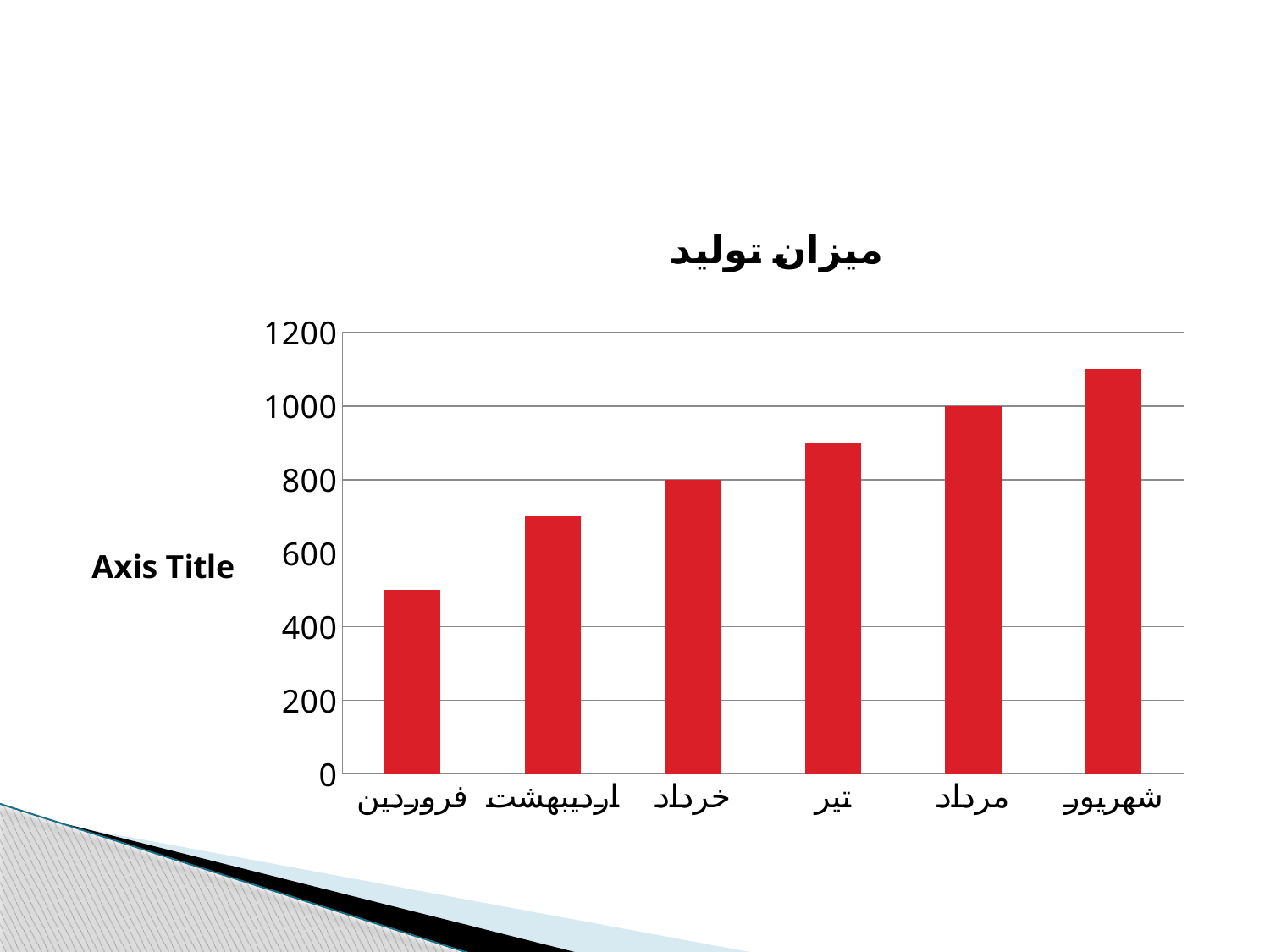
Which category has the lowest value? فروردین What is the value for مرداد? 1000 What is the title of the chart? میزان تولید How many categories are shown on the x axis of the chart? 6 Do the values rise or fall from فروردین to شهریور along the x axis? rise Is the value for فروردین greater or less than 600? less Is the value for شهریور greater or less than 1000? greater Which is larger, the value for تیر or the value for اردیبهشت? تیر What type of chart is shown on the slide? bar chart What is the difference between the values for مرداد and خرداد? 200 What is the value for خرداد? 800 Which category has the highest value? شهریور